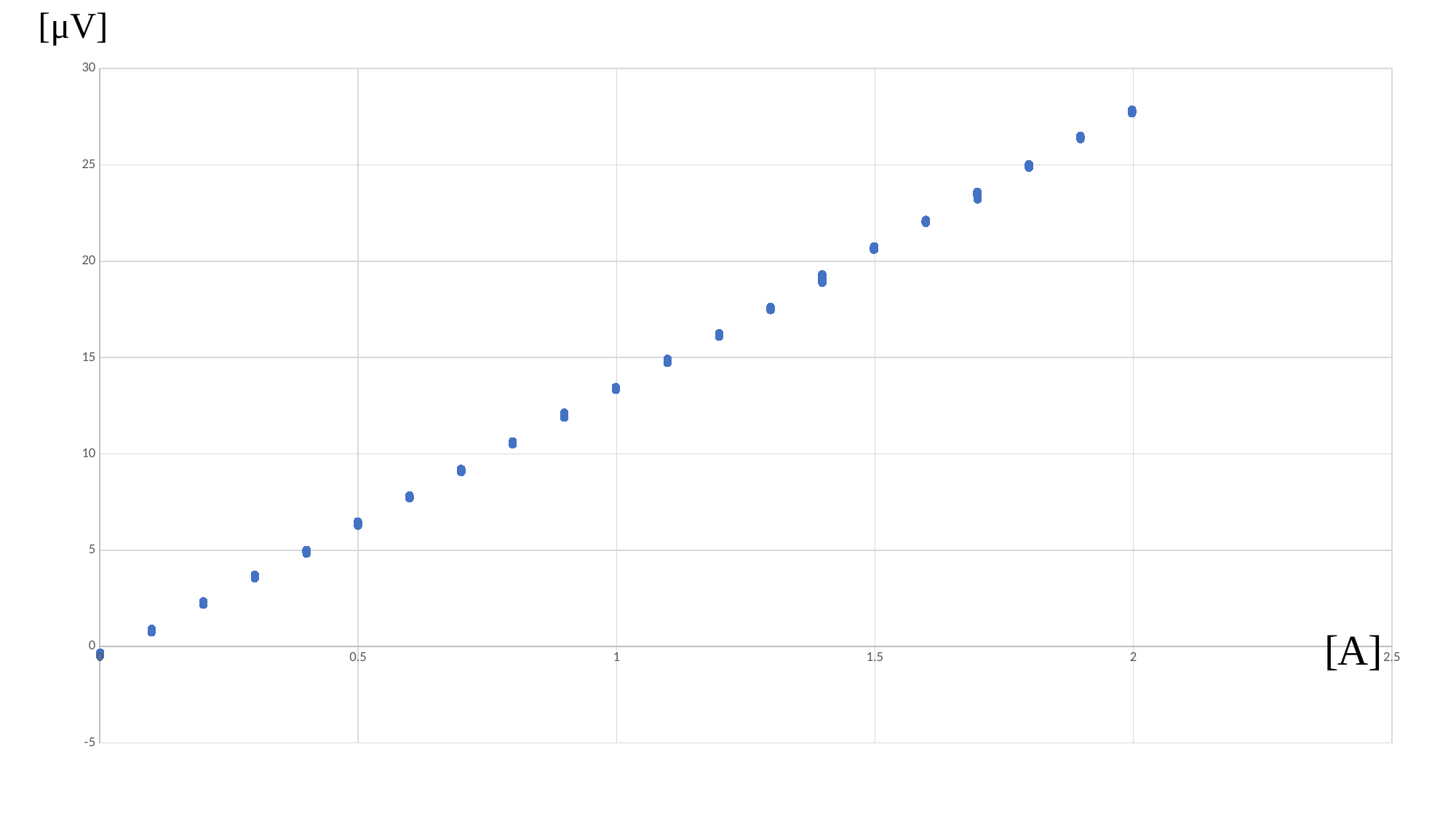
What kind of chart is shown on the slide? scatter chart What unit is shown on the y axis of the chart? [μV] Which is larger, the value at 0.5 A or the value at 1.5 A? 1.5 A At which x-axis value in [A] is the highest plotted value found? 2 Is the value at 1.5 A greater or less than 20 μV? greater Is the value at 1 A greater or less than 15 μV? less Is the value at 2 A greater or less than 25 μV? greater At which x-axis value in [A] is the lowest plotted value found? 0 What unit is shown on the x axis of the chart? [A] Do the plotted values rise or fall as the current in [A] increases along the x axis? rise